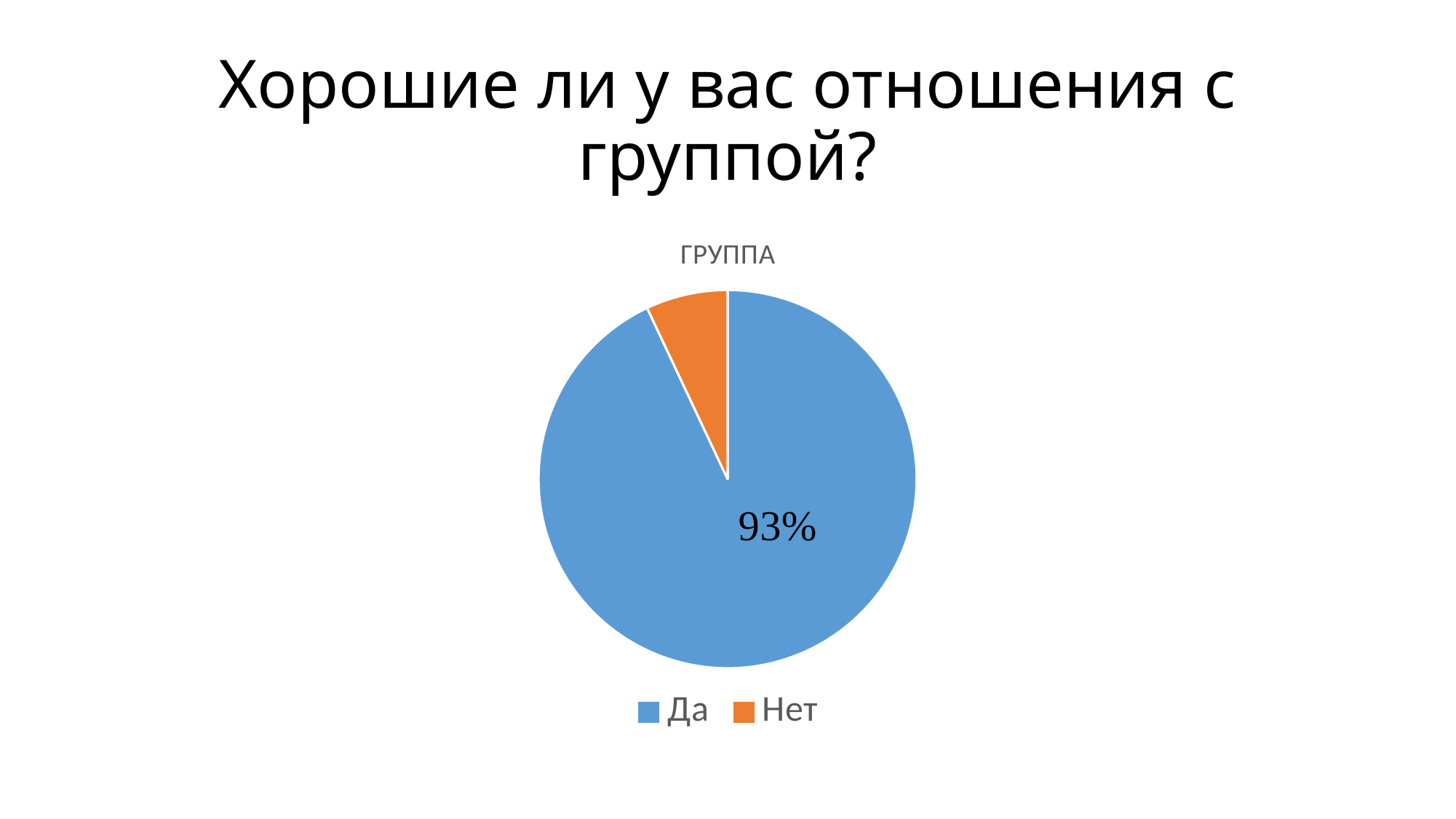
Is the share for "Да" greater or less than 50%? greater What share of the pie does the "Да" slice represent? 93% Which category has the smallest slice of the pie? Нет Which category has the largest slice of the pie? Да Which slice is larger, "Да" or "Нет"? Да What colour is the "Да" slice? blue How many entries does the legend list? 2 What kind of chart is shown on the slide? pie chart How many slices does the pie chart have? 2 What is the title of the pie chart? ГРУППА